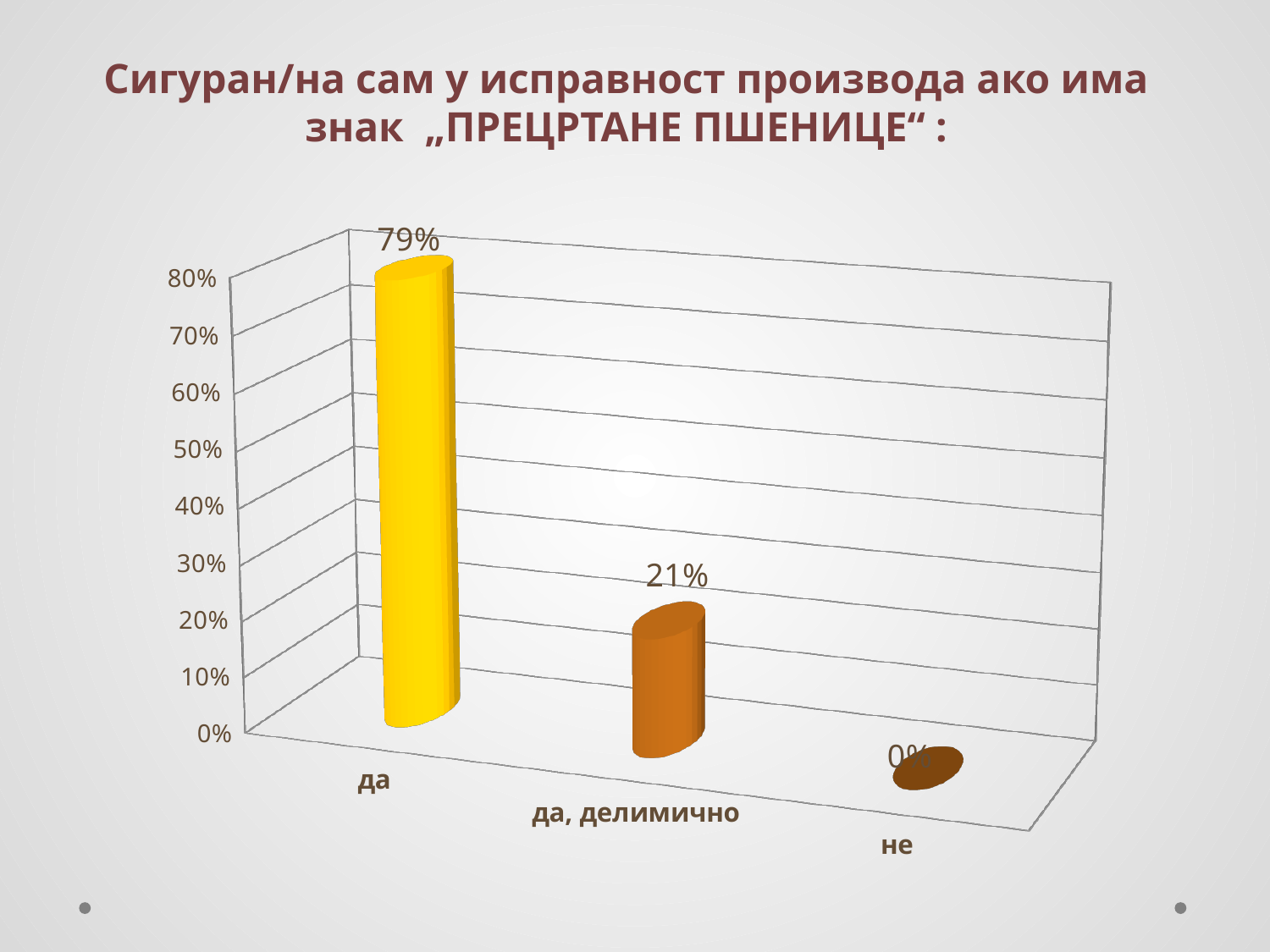
What is the highest value shown on the vertical axis? 80% Which is larger, the value for "да" or the value for "да, делимично"? да How many categories are shown on the chart? 3 What is the value for "не"? 0% Which category has the lowest value? не Is the value for "да" greater or less than 70%? greater Which category has the highest value? да What is the difference between the values for "да" and "да, делимично"? 58% What is the value for "да"? 79% Is the value for "да, делимично" greater or less than 30%? less What is the value for "да, делимично"? 21% What kind of chart is shown on the slide? bar chart